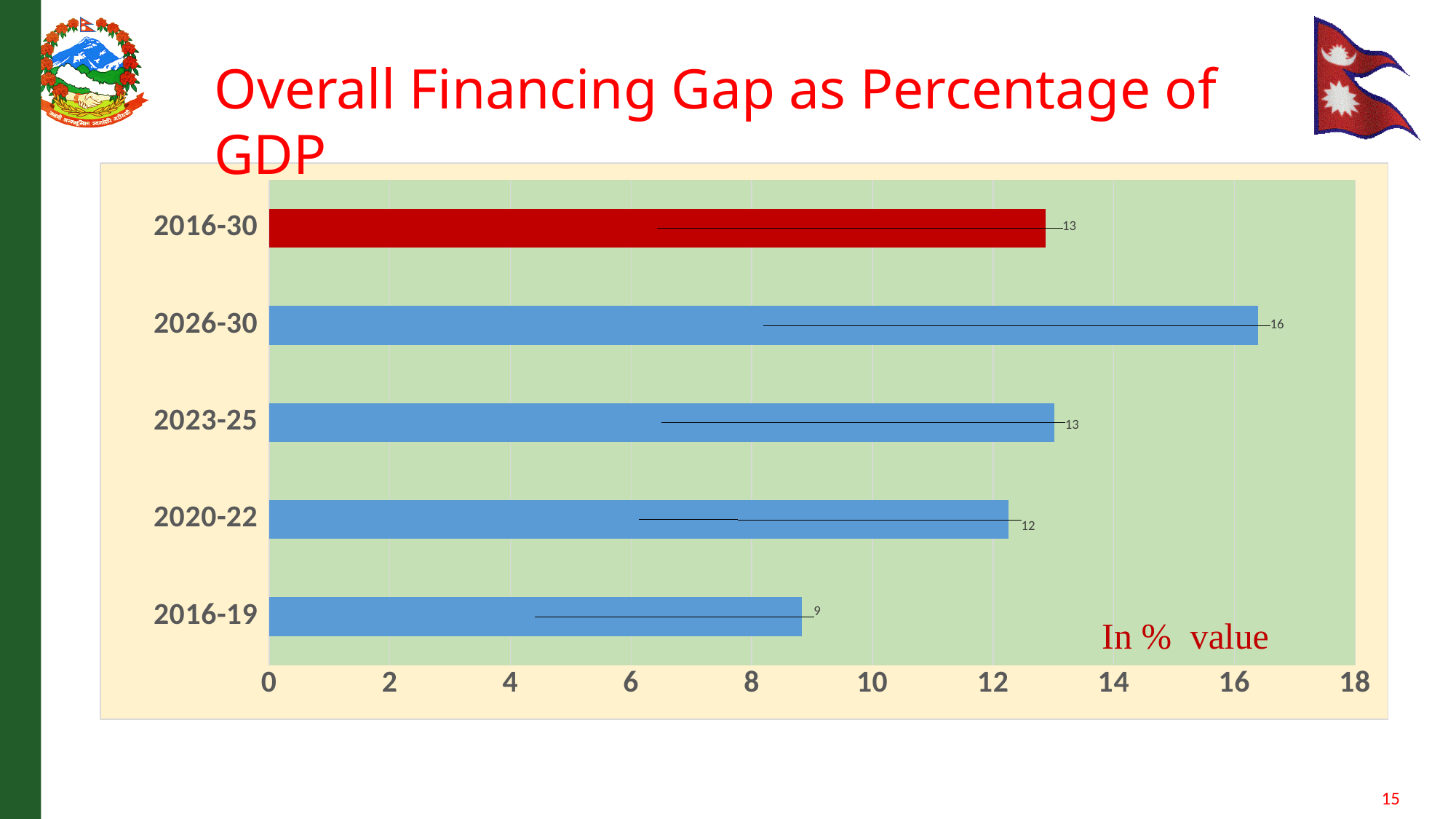
What kind of chart is shown on the slide? bar chart How many periods are shown on the chart? 5 What is the value for 2026-30? 16 Is the value for 2016-19 greater or less than 10? less Which is larger, the value for 2020-22 or the value for 2026-30? 2026-30 What is the value for 2016-19? 9 Which period has the highest financing gap as a percentage of GDP? 2026-30 What is the difference between the values for 2026-30 and 2016-19? 7 What is the value for 2020-22? 12 What colour is the bar for 2016-30? red What is the value for 2023-25? 13 Which period has the lowest financing gap as a percentage of GDP? 2016-19